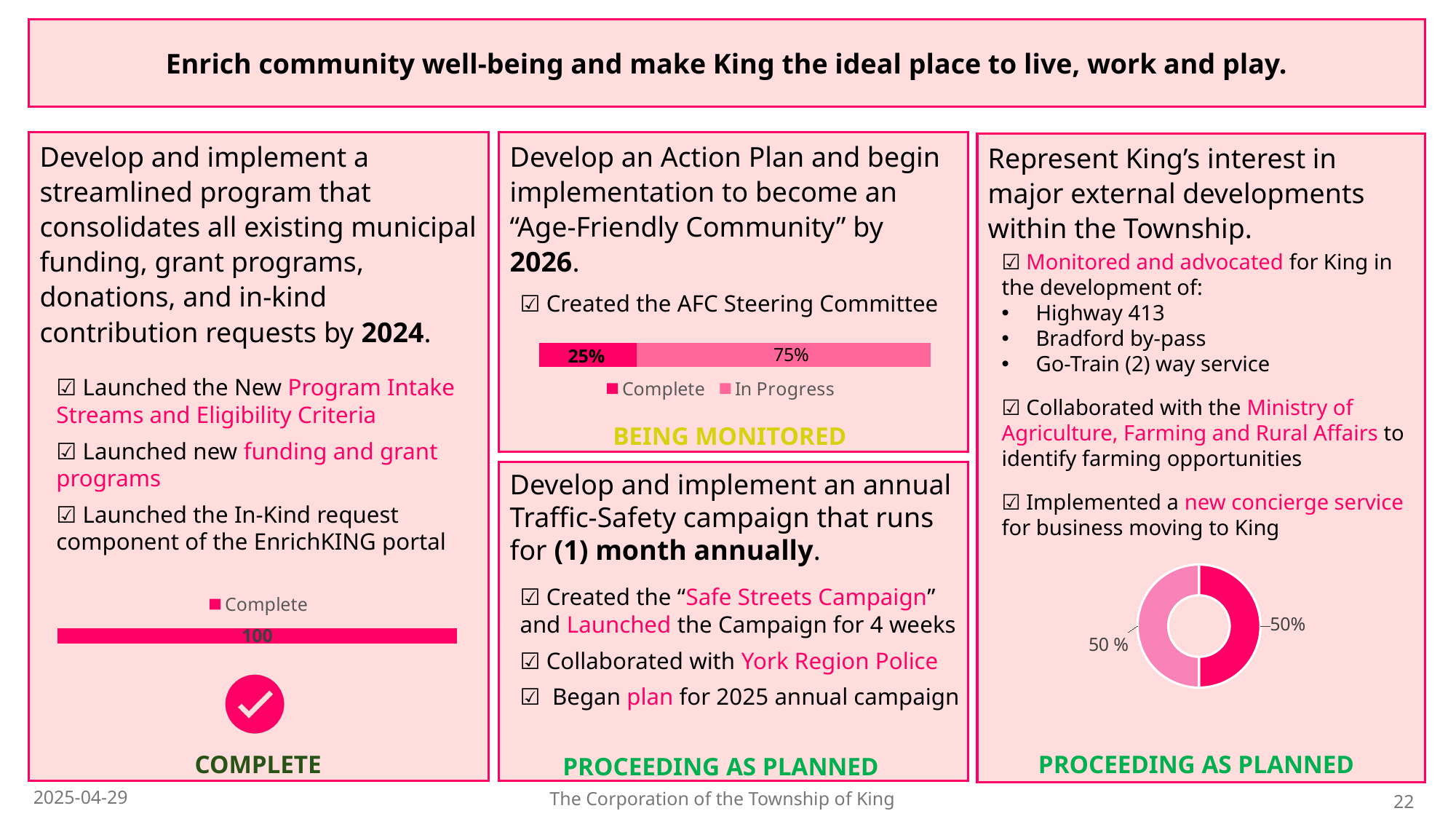
In the stacked bar chart in the middle-top panel (Age-Friendly Community), what percentage is labelled Complete? 25% What kind of chart is shown in the left panel (streamlined funding program)? Bar chart What kind of chart is shown in the middle-top panel (Age-Friendly Community)? Bar chart In the stacked bar chart in the middle-top panel (Age-Friendly Community), which segment is larger, Complete or In Progress? In Progress In the chart in the left panel (streamlined funding program), what value is printed on the Complete bar? 100 What is the only legend entry for the chart in the left panel (streamlined funding program)? Complete In the pie chart in the right panel (Represent King's interest in major external developments), what share does the dark pink slice represent? 50% How many series does the legend list for the stacked bar chart in the middle-top panel (Age-Friendly Community)? 2 In the stacked bar chart in the middle-top panel (Age-Friendly Community), what is the total of the two segments? 100% In the stacked bar chart in the middle-top panel (Age-Friendly Community), what is the difference between the In Progress and Complete percentages? 50% What kind of chart is shown in the right panel (Represent King's interest in major external developments)? Doughnut chart In the stacked bar chart in the middle-top panel (Age-Friendly Community), what percentage is labelled In Progress? 75%